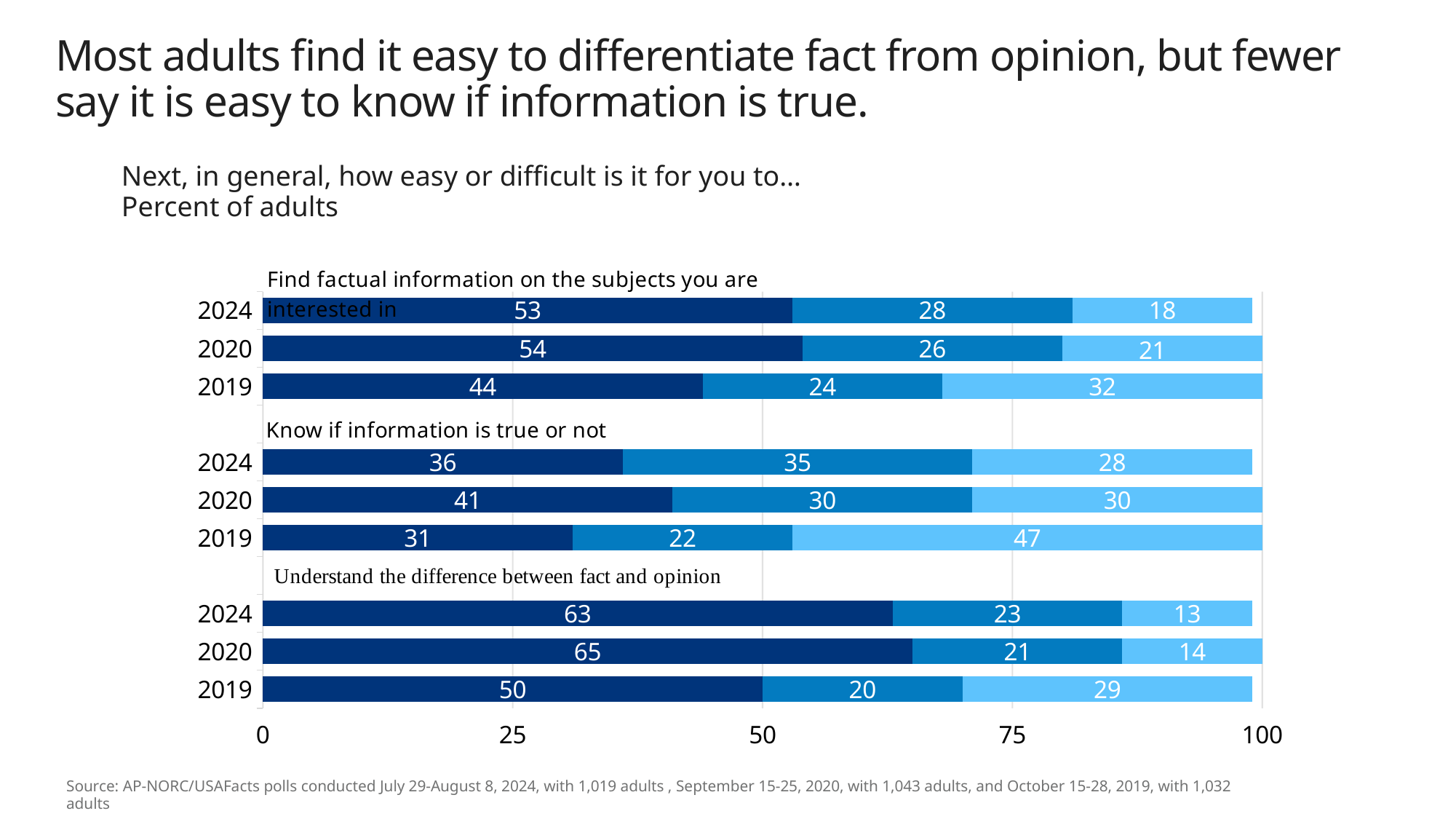
Under "Understand the difference between fact and opinion", is the darkest-blue segment for 2019 greater or less than 25? greater What is the maximum value shown on the horizontal axis? 100 What kind of chart is shown on the slide? stacked bar chart What is the difference between the darkest-blue segment for 2020 and for 2019 under "Understand the difference between fact and opinion"? 15 What is the total of the three segments for the 2024 bar under "Find factual information on the subjects you are interested in"? 99 How many bars are plotted on the chart in total? 9 What is the value of the lightest-blue segment for 2019 under "Know if information is true or not"? 47 Among the 2024 bars, which question has the largest darkest-blue segment? Understand the difference between fact and opinion What is the value of the middle (medium-blue) segment for 2020 under "Find factual information on the subjects you are interested in"? 26 Under "Know if information is true or not", is the darkest-blue segment larger for 2020 or for 2024? 2020 Among the 2019 bars, which question has the smallest darkest-blue segment? Know if information is true or not What is the value of the darkest-blue segment for 2024 under "Understand the difference between fact and opinion"? 63